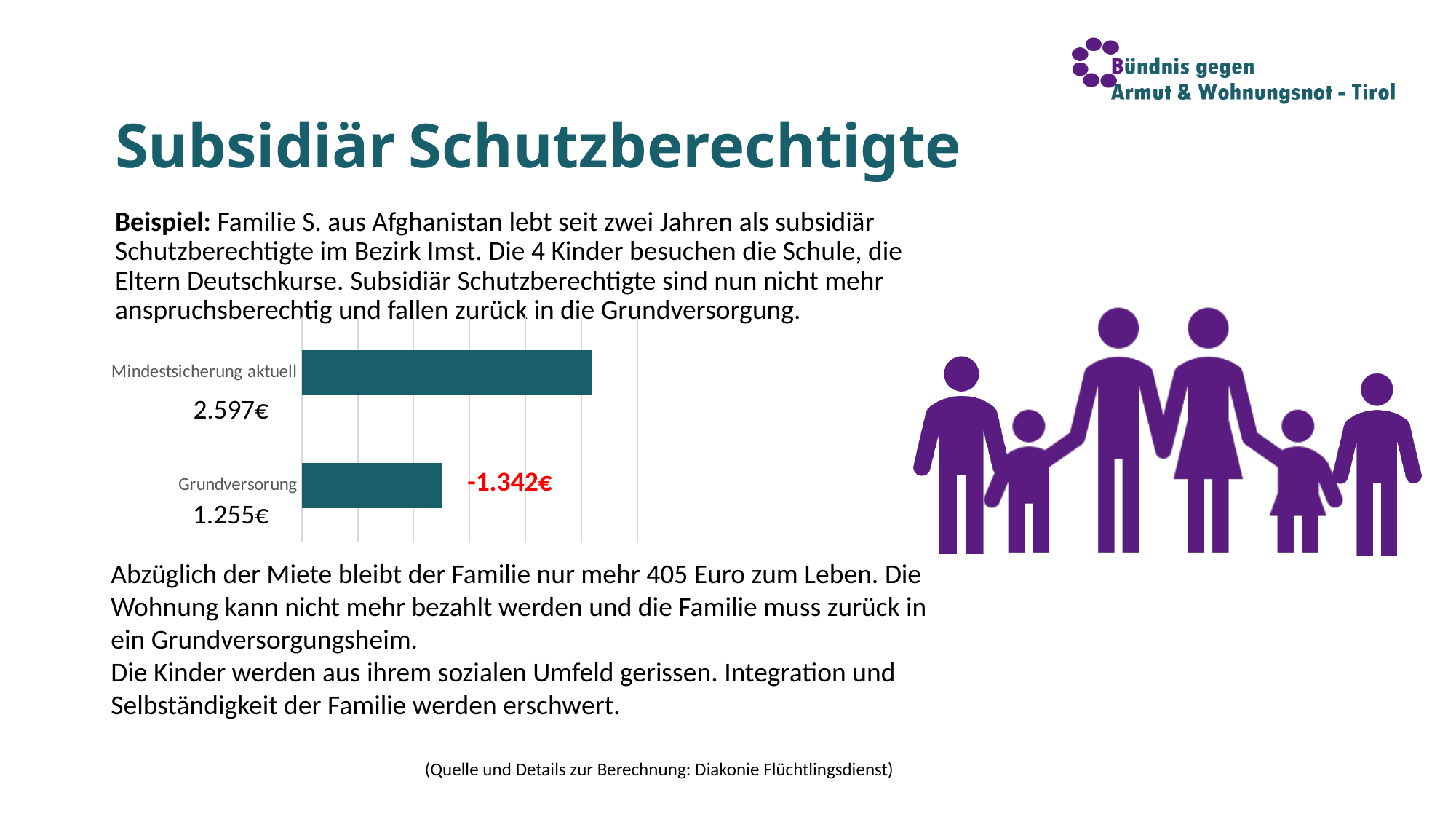
What is the value shown for Mindestsicherung aktuell? 2.597€ How many categories does the bar chart show? 2 What is the value shown for Grundversorung? 1.255€ What kind of chart is shown on the slide? bar chart What colour are the bars in the chart? dark teal What difference value is printed in red next to the Grundversorung bar? -1.342€ Which category has the lowest value in the bar chart? Grundversorung Which is larger, the value for Mindestsicherung aktuell or the value for Grundversorung? Mindestsicherung aktuell Which category has the highest value in the bar chart? Mindestsicherung aktuell Are the bars in the chart horizontal or vertical? horizontal What is the difference between the value for Mindestsicherung aktuell and the value for Grundversorung? 1.342€